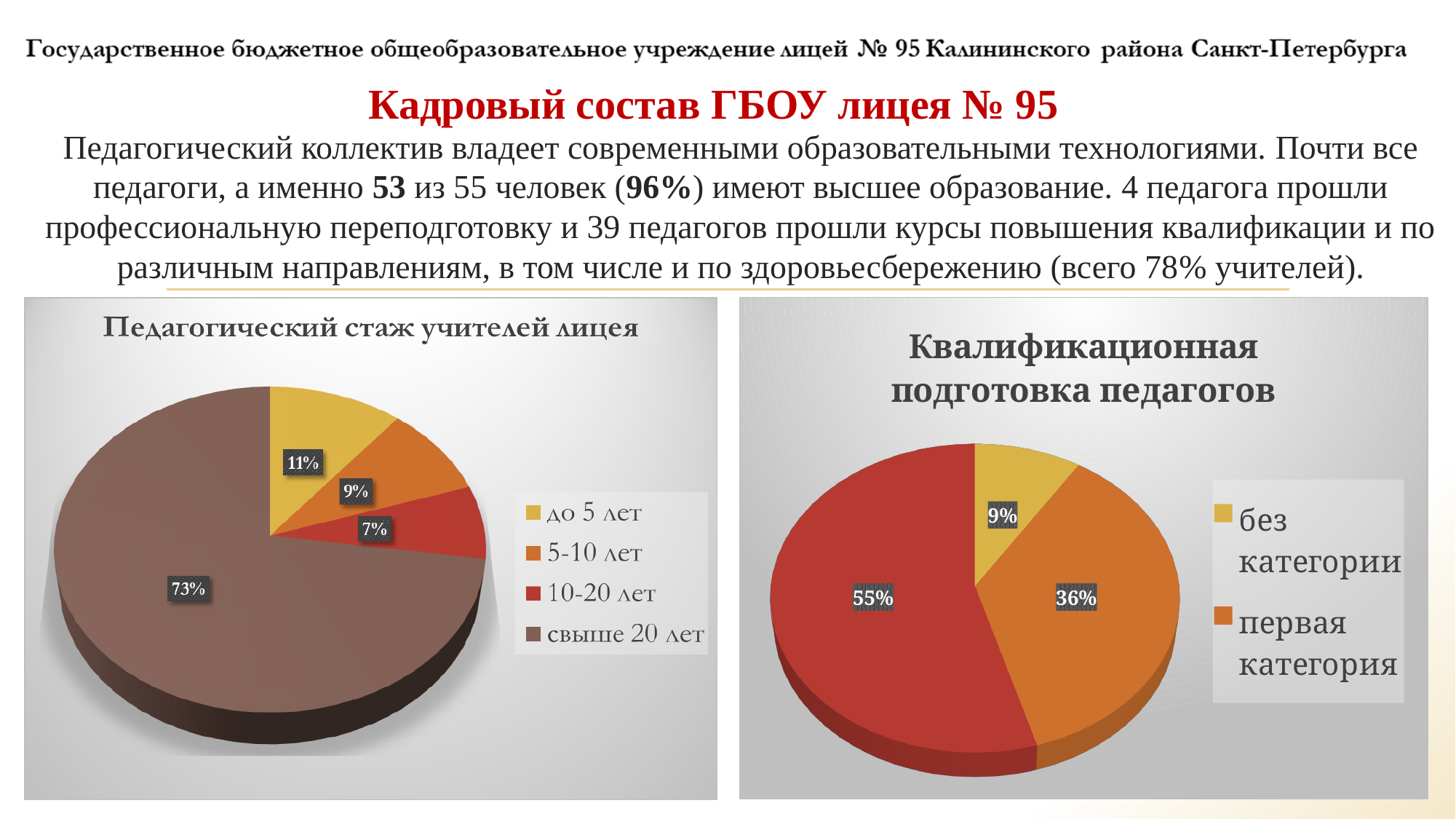
In the chart titled "Педагогический стаж учителей лицея", what is the difference between "до 5 лет" and "5-10 лет"? 2% In the chart titled "Педагогический стаж учителей лицея", what is the value for "до 5 лет"? 11% What type of chart is the chart titled "Педагогический стаж учителей лицея"? Pie chart In the chart titled "Педагогический стаж учителей лицея", how many categories does the legend list? 4 In the chart titled "Педагогический стаж учителей лицея", what share of teachers have "свыше 20 лет" of experience? 73% In the chart titled "Педагогический стаж учителей лицея", which category has the largest slice? свыше 20 лет In the chart titled "Квалификационная подготовка педагогов", what is the value for "без категории"? 9% In the chart titled "Педагогический стаж учителей лицея", which category has the smallest slice? 10-20 лет In the chart titled "Квалификационная подготовка педагогов", what is the value for "первая категория"? 36% In the chart titled "Квалификационная подготовка педагогов", what is the value of the largest slice? 55% In the chart titled "Педагогический стаж учителей лицея", what is the value for "10-20 лет"? 7% In the chart titled "Квалификационная подготовка педагогов", which is larger: "без категории" or "первая категория"? первая категория